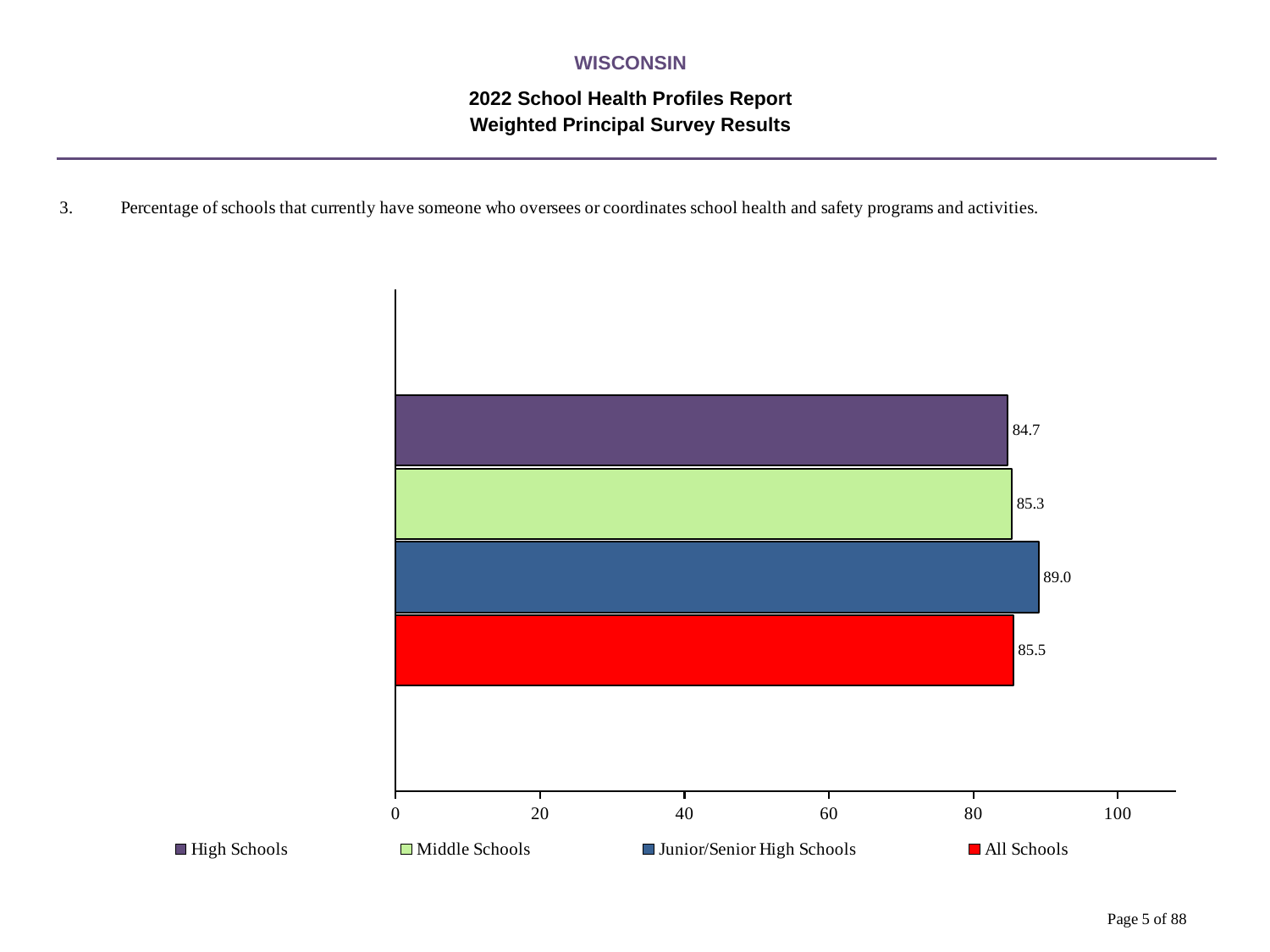
What is the value for Middle Schools? 85.3 What is the difference between the values for Junior/Senior High Schools and High Schools? 4.3 What is the value for All Schools? 85.5 Is the value for High Schools greater or less than 80? greater What kind of chart is shown on the slide? Bar chart Which is larger, the value for Junior/Senior High Schools or the value for Middle Schools? Junior/Senior High Schools How many bars are plotted in the chart? 4 Which school type has the lowest value? High Schools What is the value for High Schools? 84.7 How many entries does the legend list? 4 Which school type has the highest value? Junior/Senior High Schools What is the value for Junior/Senior High Schools? 89.0